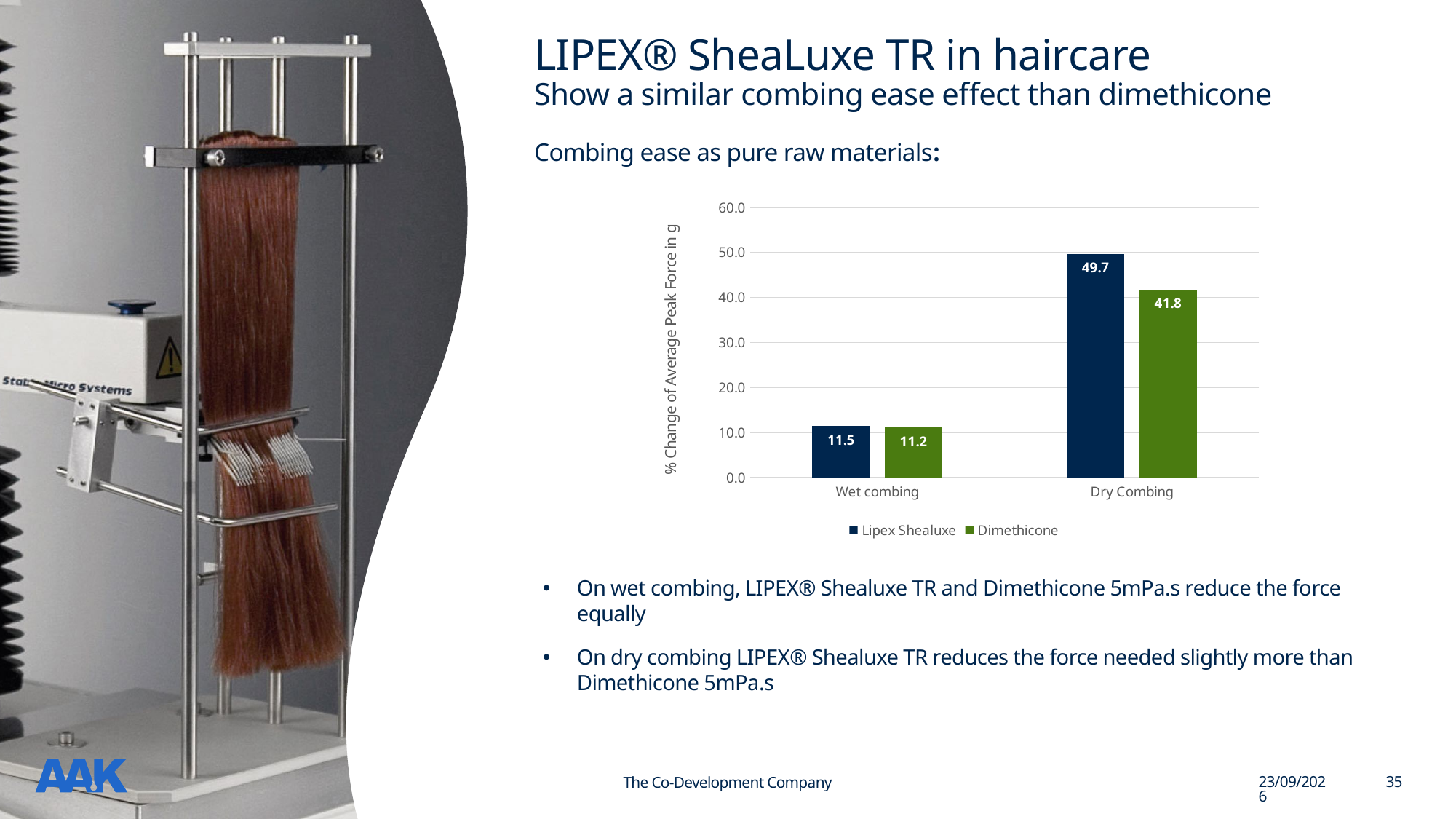
What is the value for Dimethicone in the Dry Combing category? 41.8 What is the label of the y axis? % Change of Average Peak Force in g How many categories are shown on the x axis? 2 What is the value for Lipex Shealuxe in the Dry Combing category? 49.7 In the Dry Combing category, which series has the larger value, Lipex Shealuxe or Dimethicone? Lipex Shealuxe Which category has the highest value for Lipex Shealuxe? Dry Combing Which category has the lowest value for Dimethicone? Wet combing What is the value for Lipex Shealuxe in the Wet combing category? 11.5 How many series does the legend list? 2 What is the value for Dimethicone in the Wet combing category? 11.2 What kind of chart is shown on the slide? Bar chart What is the difference between Lipex Shealuxe and Dimethicone in the Dry Combing category? 7.9